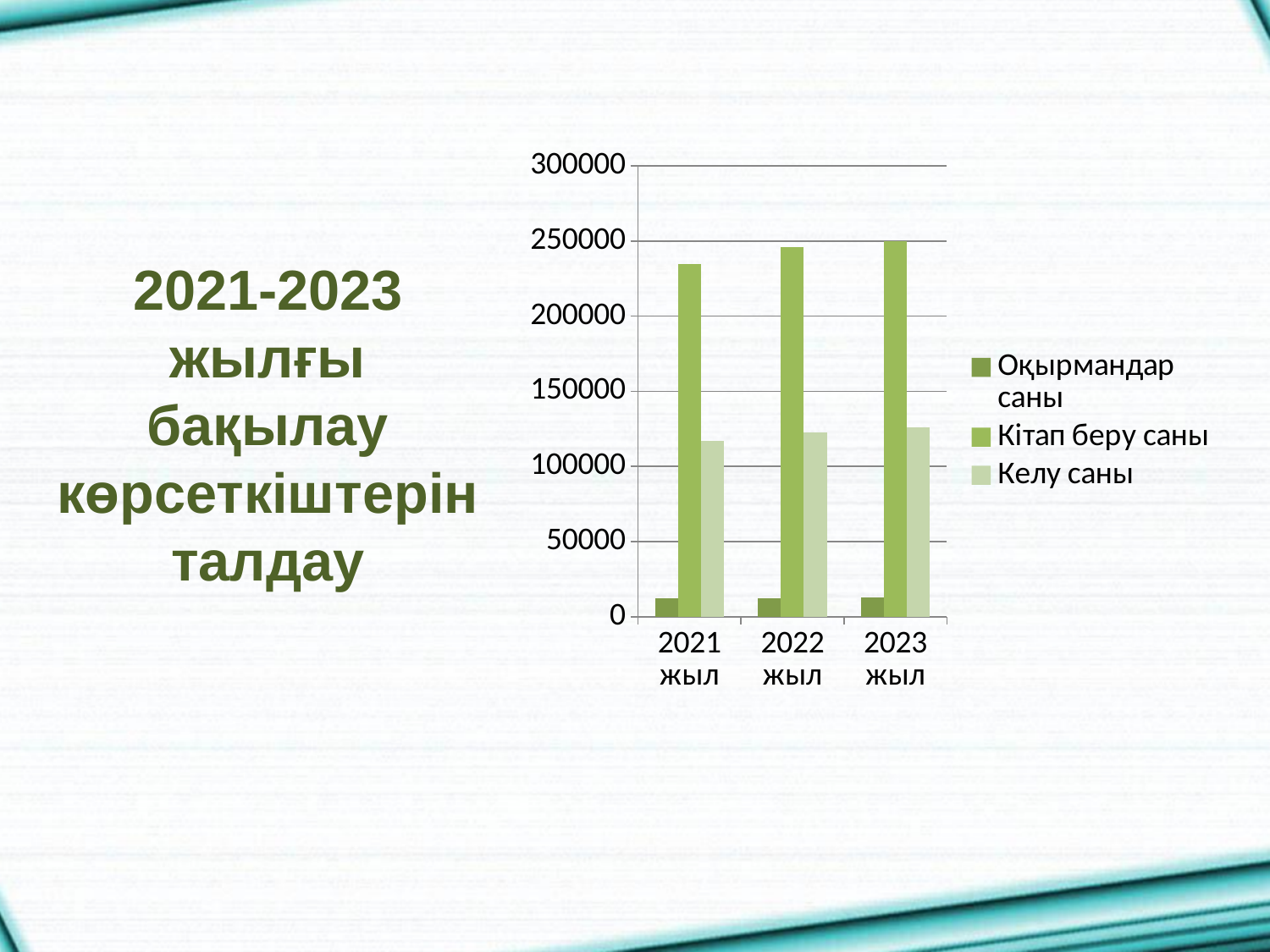
Do the values for Кітап беру саны rise or fall from 2021 жыл to 2023 жыл? rise In 2021 жыл, which is larger: Кітап беру саны or Келу саны? Кітап беру саны How many series does the chart legend list? 3 Is the value for Оқырмандар саны in 2022 жыл greater or less than 50000? less Is the value for Келу саны in 2021 жыл greater or less than 100000? greater How many year categories are shown on the x axis of the chart? 3 Which series has the lowest values in every year? Оқырмандар саны Is the value for Кітап беру саны in 2021 жыл greater or less than 200000? greater What kind of chart is shown on the slide? bar chart In which year is Кітап беру саны the lowest? 2021 жыл Which series is shown in the lightest green colour in the legend? Келу саны